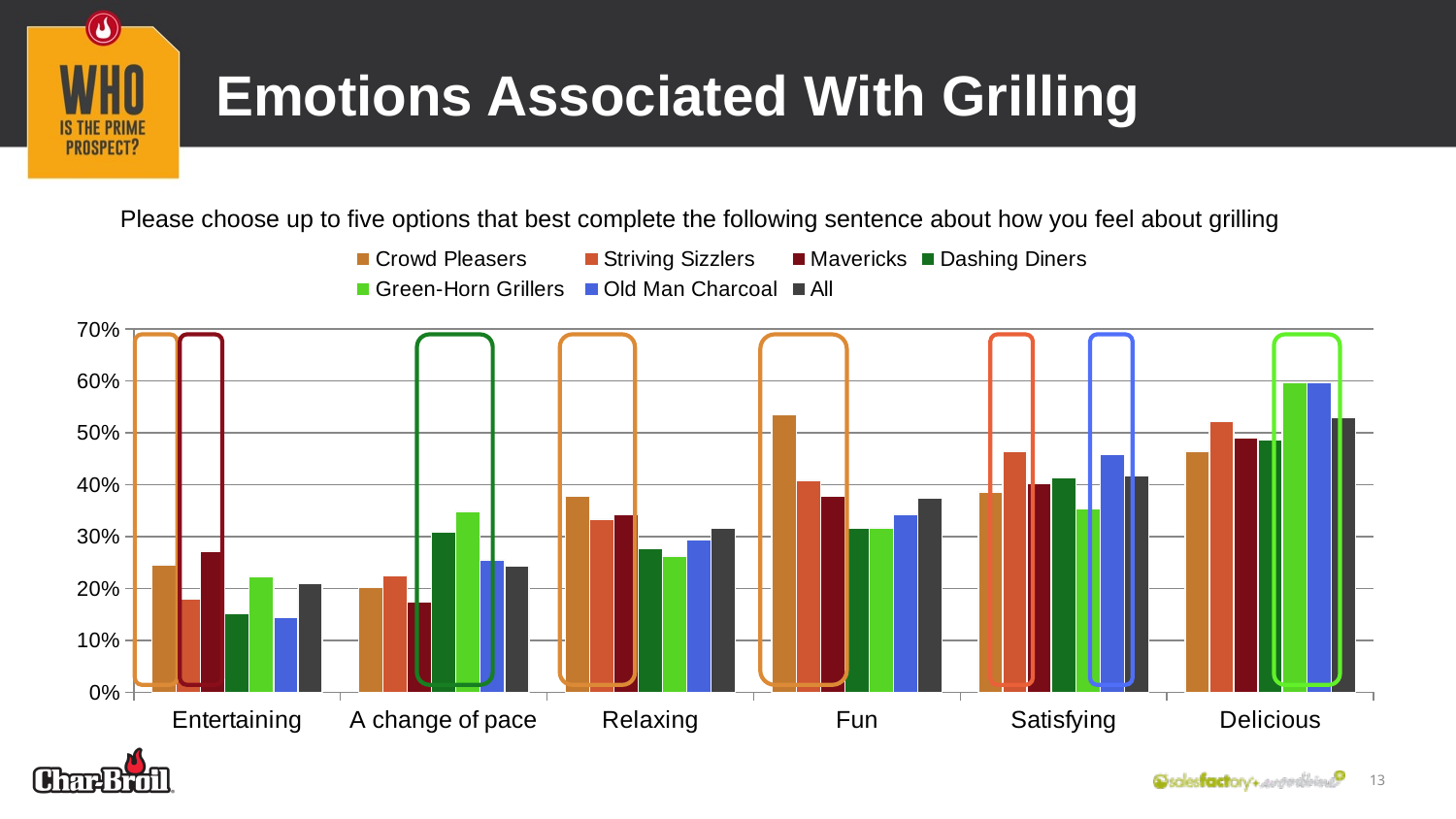
Is the value for Old Man Charcoal in the Entertaining category greater or less than 20%? less What colour represents the Old Man Charcoal series in the legend? blue How many series does the legend list? 7 In the A change of pace category, which is larger: Green-Horn Grillers or Mavericks? Green-Horn Grillers Is the value for Striving Sizzlers in the Satisfying category greater or less than 40%? greater In the Fun category, which is larger: Crowd Pleasers or Striving Sizzlers? Crowd Pleasers Is the value for Green-Horn Grillers in the Delicious category greater or less than 50%? greater How many emotion categories are shown along the x axis? 6 What kind of chart is shown on the slide? bar chart Which category has the lowest value for the All series? Entertaining Which category has the highest value for the All series? Delicious